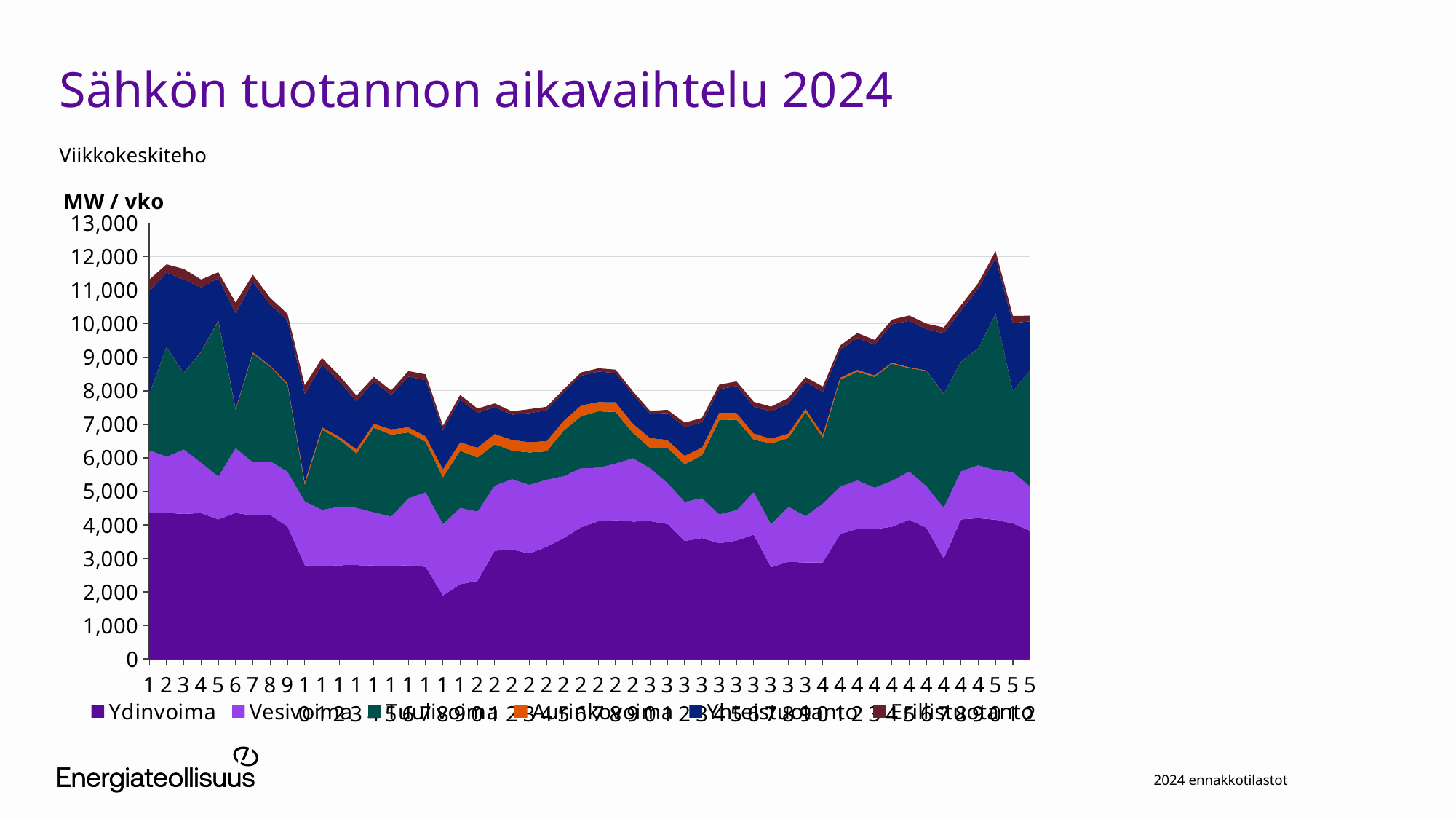
Is the total stacked value in week 50 greater or less than 11,000? greater What is the title of the chart on the slide? Sähkön tuotannon aikavaihtelu 2024 Is the Ydinvoima value in week 19 greater or less than 3,000? less Does the Ydinvoima value rise or fall from week 1 to week 10? Fall Is the Ydinvoima value in week 1 greater or less than 4,000? greater Which is larger, the Ydinvoima value in week 1 or in week 19? Week 1 How many weeks are plotted along the x axis of the chart? 52 Does the total stacked value rise or fall from week 40 to week 50? Rise How many series does the chart's legend list? 6 What unit label is shown above the vertical axis of the chart? MW / vko What kind of chart is shown on the slide? Stacked area chart